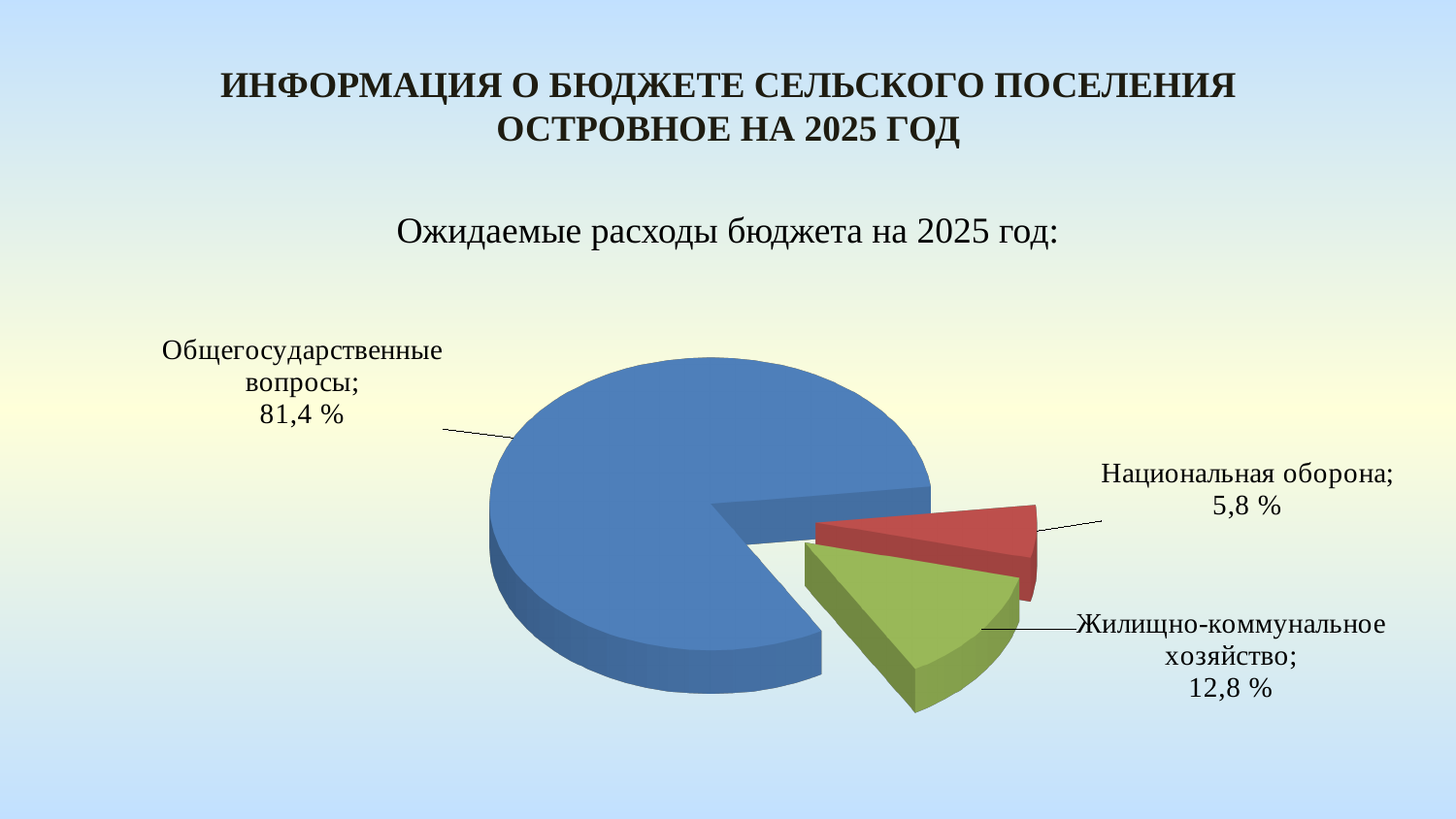
What is the difference in percentage points between Общегосударственные вопросы and Жилищно-коммунальное хозяйство? 68,6 What is the difference in percentage points between Жилищно-коммунальное хозяйство and Национальная оборона? 7,0 How many categories are shown in the pie chart? 3 What share of the expected 2025 budget expenses goes to Общегосударственные вопросы? 81,4 % Which is larger: the share for Жилищно-коммунальное хозяйство or the share for Национальная оборона? Жилищно-коммунальное хозяйство Which category has the smallest share of the expected 2025 budget expenses? Национальная оборона What share of the expected 2025 budget expenses goes to Жилищно-коммунальное хозяйство? 12,8 % What kind of chart is shown on the slide? Pie chart What share of the expected 2025 budget expenses goes to Национальная оборона? 5,8 % What colour is the slice for Общегосударственные вопросы? Blue Which category has the largest share of the expected 2025 budget expenses? Общегосударственные вопросы What is the subtitle above the pie chart? Ожидаемые расходы бюджета на 2025 год: